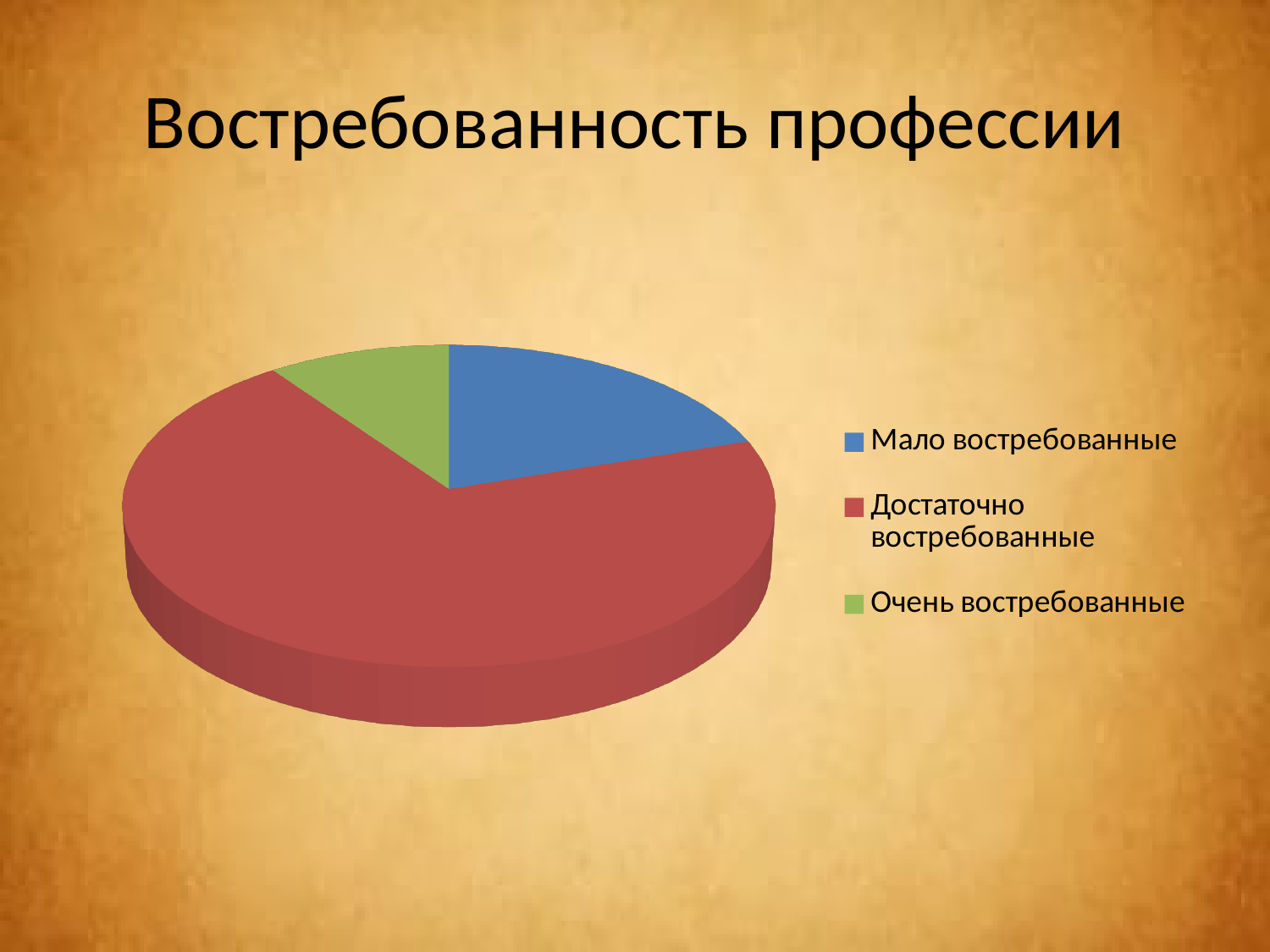
What is the title of the chart on the slide? Востребованность профессии How many entries does the legend list? 3 Which category has the smallest slice of the pie? Очень востребованные Which slice is larger: Достаточно востребованные or Мало востребованные? Достаточно востребованные What kind of chart is shown on the slide? Pie chart How many slices does the pie chart have? 3 Which category has the largest slice of the pie? Достаточно востребованные What colour is the slice for Достаточно востребованные? Red Which slice is larger: Мало востребованные or Очень востребованные? Мало востребованные